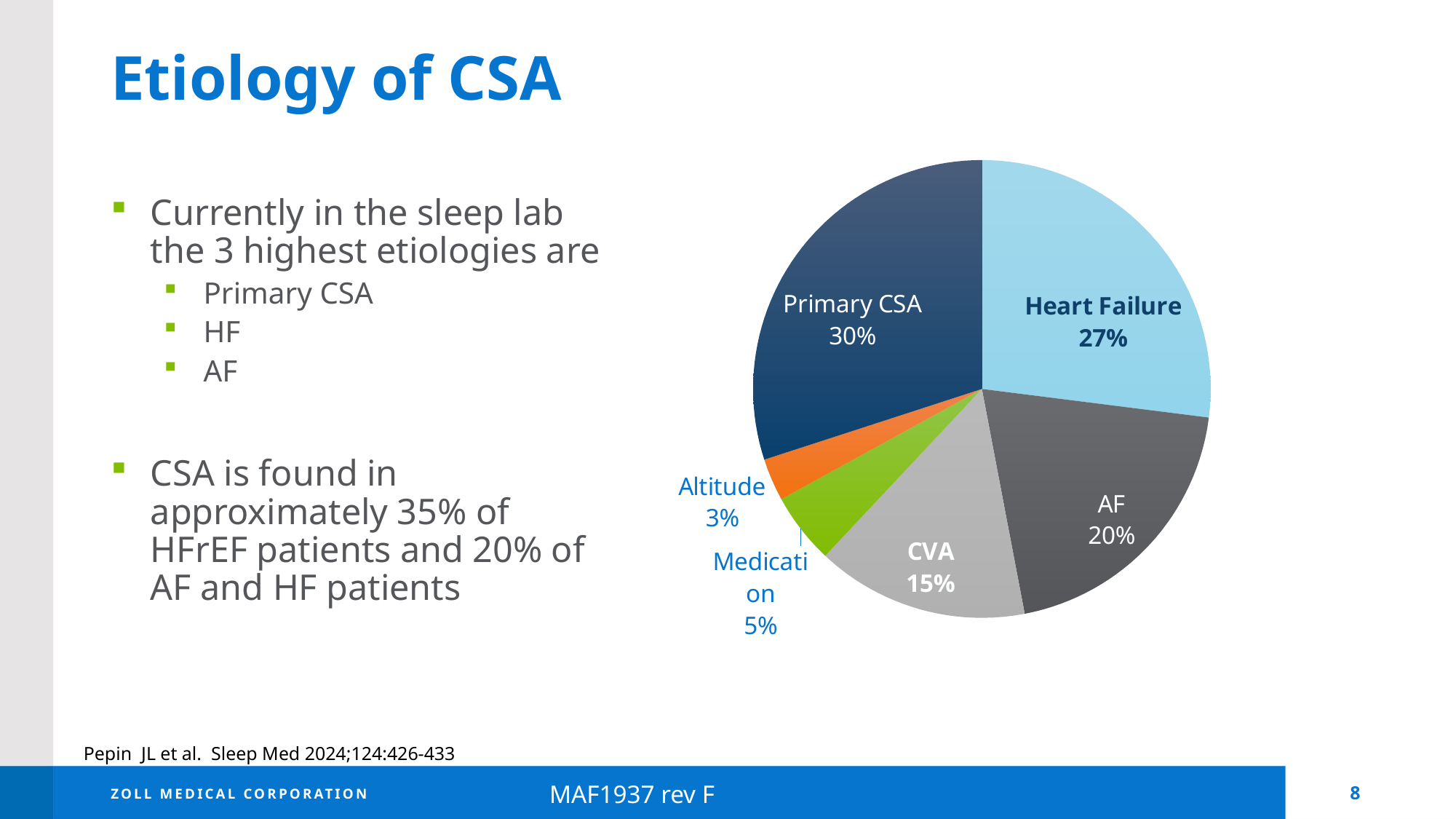
How many categories are shown in the pie chart? 6 Which is larger, the AF slice or the CVA slice? AF Which category has the smallest slice of the pie? Altitude What kind of chart is shown on the slide? pie chart What share of the pie does Primary CSA account for? 30% What is the value shown for AF? 20% What is the difference between the Medication and Altitude shares? 2% Which category has the largest slice of the pie? Primary CSA What is the value shown for Altitude? 3% What is the difference between the Primary CSA and Heart Failure shares? 3% What is the value shown for CVA? 15% What is the value shown for Heart Failure? 27%